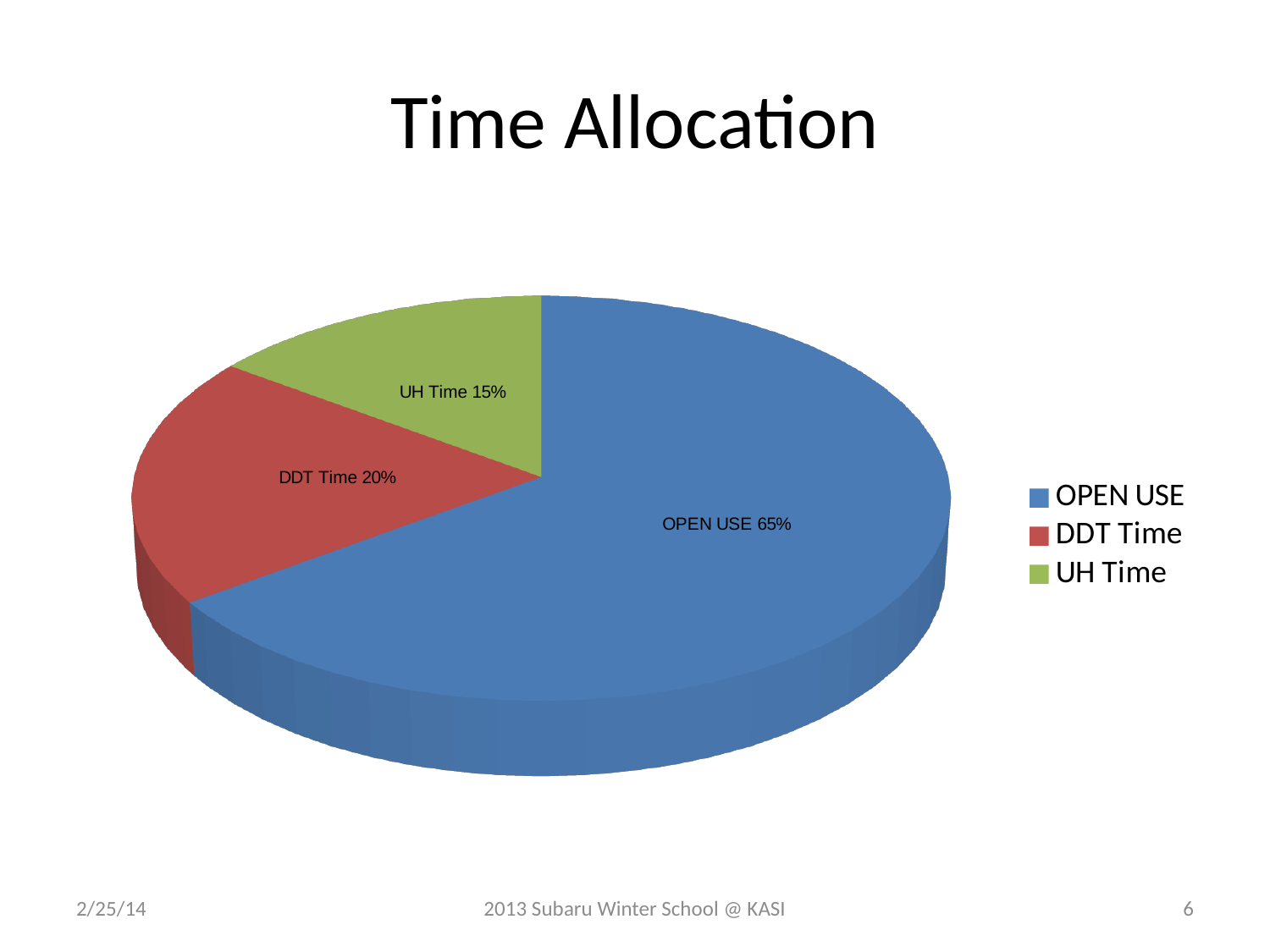
Which category has the largest slice of the pie? OPEN USE What is the difference in percentage points between OPEN USE and DDT Time? 45 What share of the pie does UH Time take? 15% How many slices does the pie chart have? 3 What is the difference in percentage points between DDT Time and UH Time? 5 How many entries does the legend list? 3 What kind of chart is shown on the slide? Pie chart Which category has the smallest slice of the pie? UH Time What share of the pie does DDT Time take? 20% Which is larger, DDT Time or UH Time? DDT Time What share of the pie does OPEN USE take? 65% What is the title of the slide containing the chart? Time Allocation